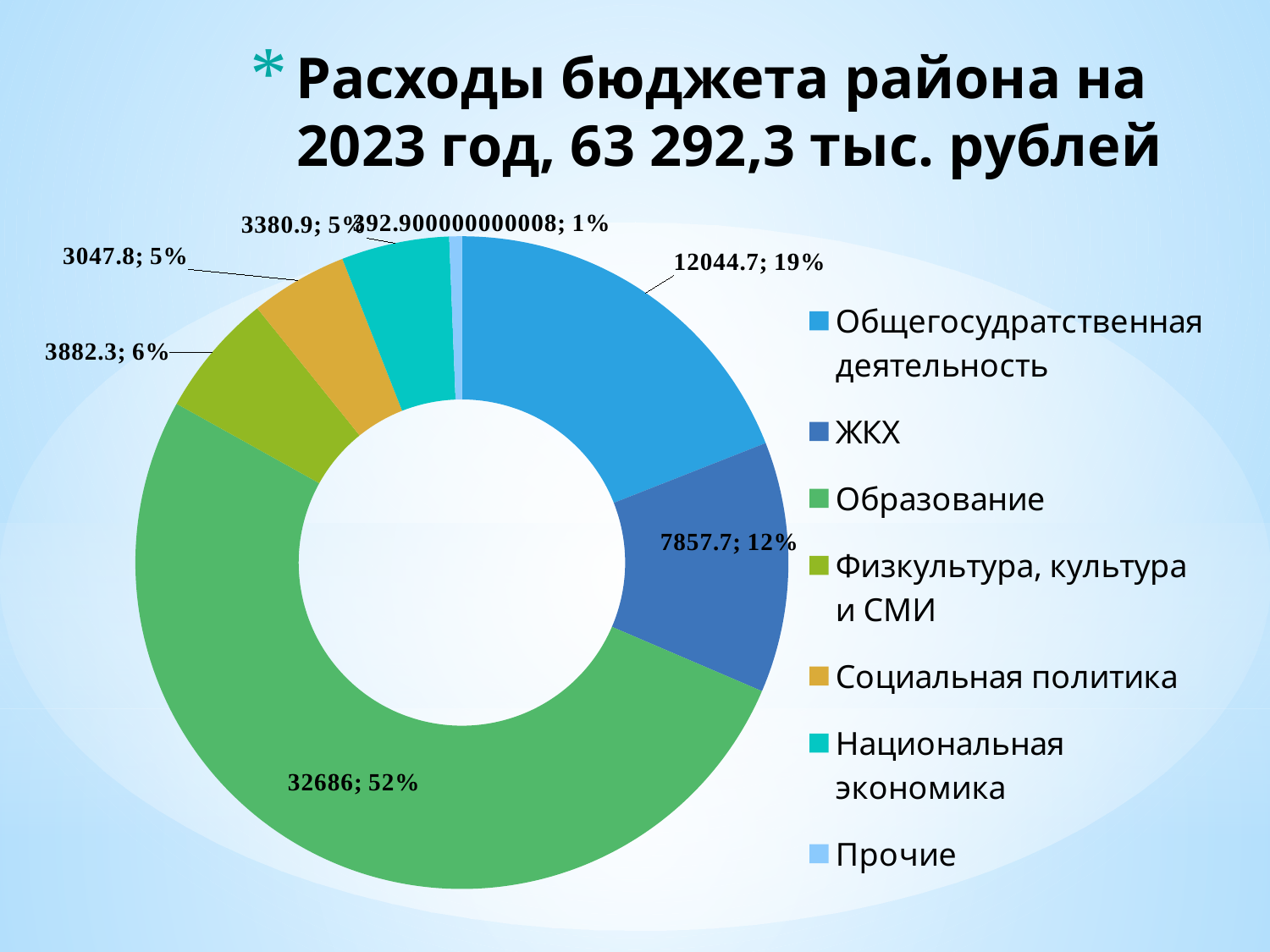
Which category has the largest value? Образование How many categories does the chart show? 7 What is the value for Физкультура, культура и СМИ? 3882.3 What is the value for ЖКХ? 7857.7 What colour is the Образование slice? green What is the value for Образование? 32686 What kind of chart is shown on the slide? doughnut chart What share of the pie does Общегосудратственная деятельность take? 19% Which is larger, Общегосудратственная деятельность or ЖКХ? Общегосудратственная деятельность Which category has the smallest value? Прочие What share of the pie does Образование take? 52% What is the difference between the values for Общегосудратственная деятельность and ЖКХ? 4187